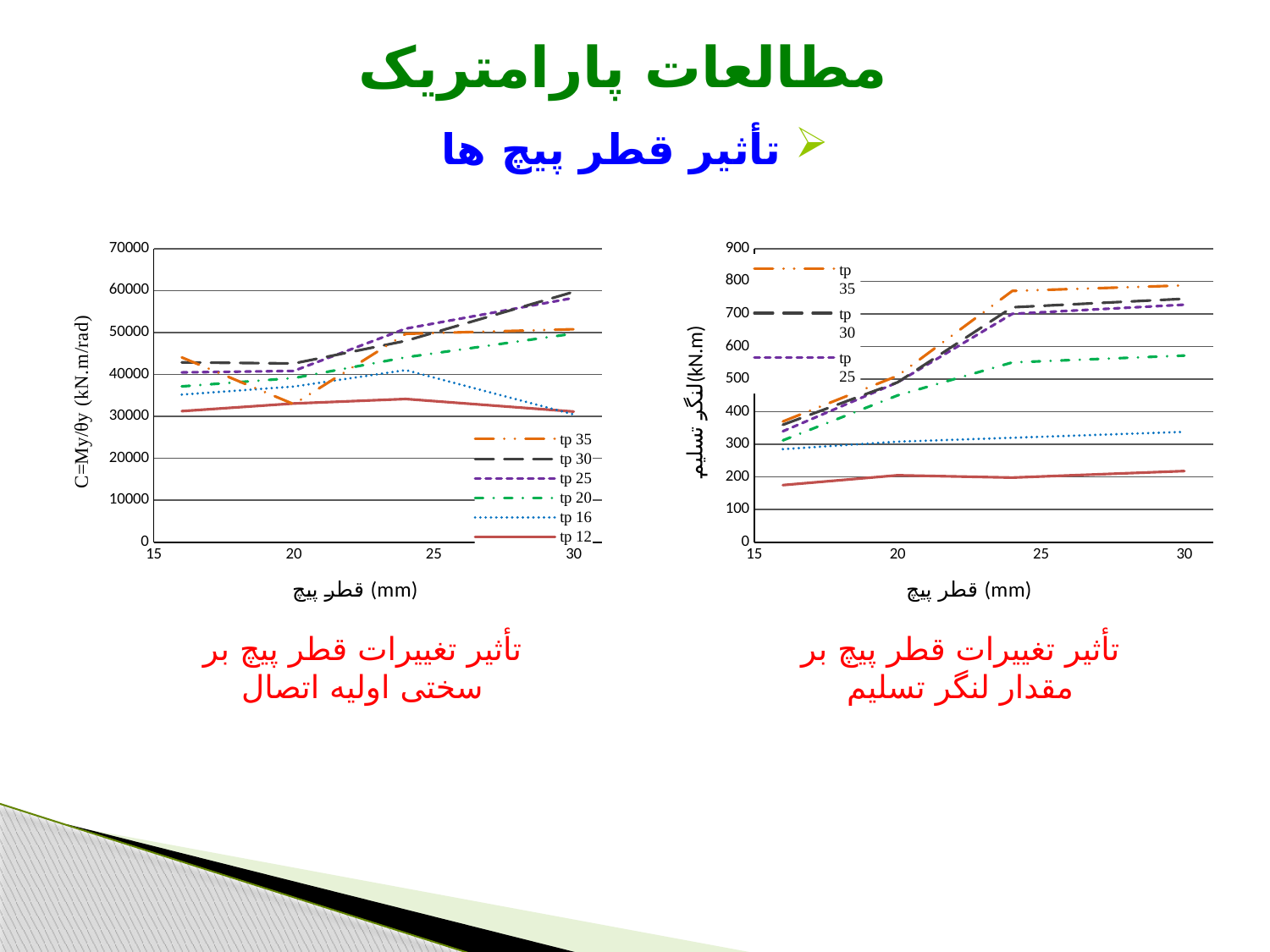
What is the y-axis label of the left chart? C=My/θy (kN.m/rad) In the right chart, is the value of tp 20 at 30 mm greater or less than 500? greater In the right chart, which series has the highest value at 30 mm? tp 35 How many series does the legend of the left chart list? 6 What kind of chart is the left chart (C=My/θy vs bolt diameter)? line chart In the right chart, is the value of tp 35 at 24 mm greater or less than 700? greater In the left chart, which series has the lowest value at 16 mm? tp 12 In the left chart, is the value of tp 30 at 30 mm greater or less than 50000? greater In the right chart, which series has the lowest value at 30 mm? tp 12 In the right chart, does the tp 35 series rise or fall as bolt diameter increases from 16 mm to 30 mm? rise